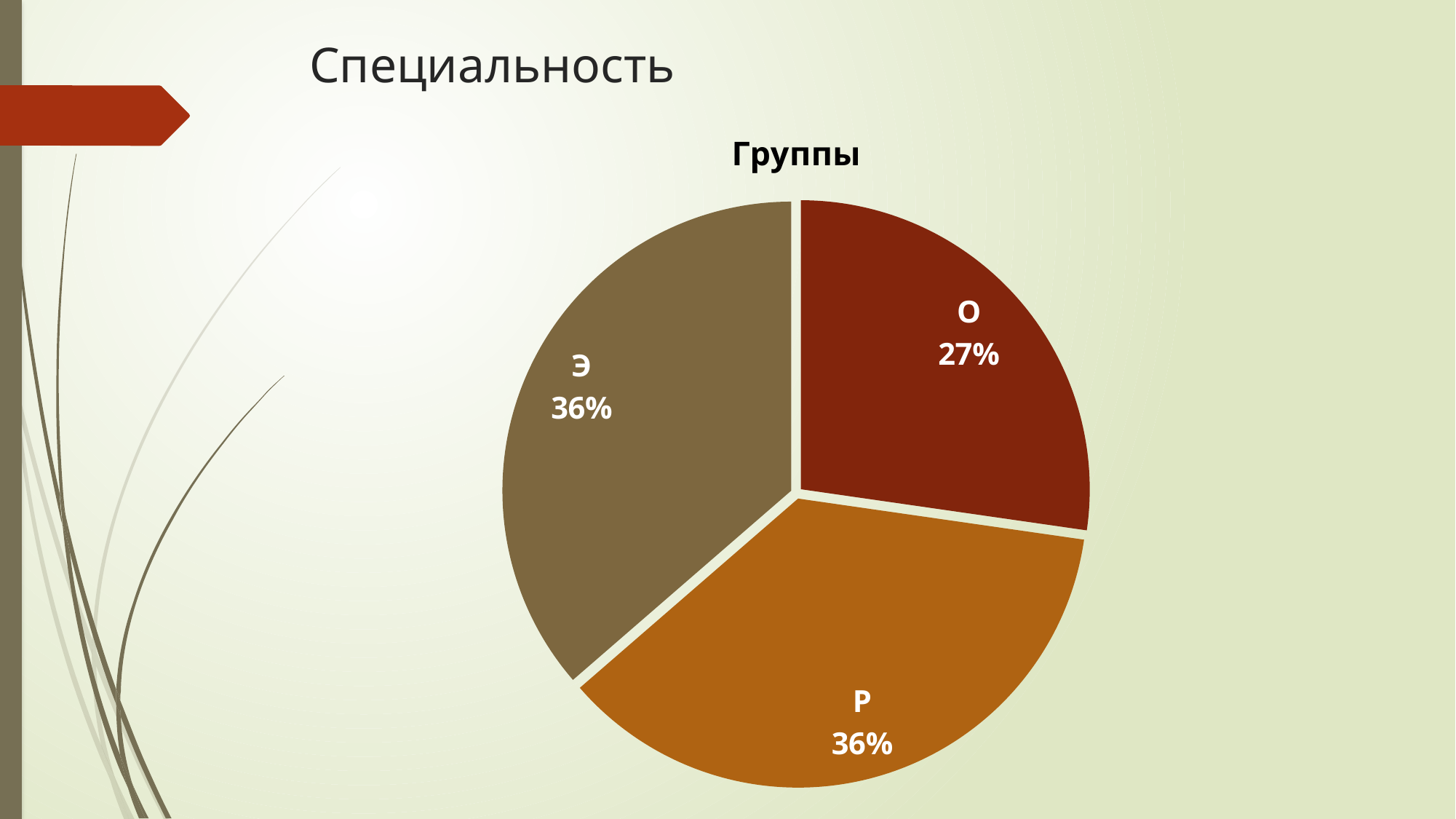
What percentage does the Э slice represent in the Группы pie chart? 36% Do the Р and Э slices in the Группы pie chart have the same percentage? Yes What type of chart is shown on the slide? Pie chart By how many percentage points does the Р share exceed the О share in the Группы pie chart? 9 Which group has the smallest share in the Группы pie chart? О What is the title of the slide? Специальность How many slices does the Группы pie chart have? 3 Which is larger in the Группы pie chart, the share for О or the share for Р? Р Which is larger in the Группы pie chart, the share for Э or the share for О? Э What percentage does the Р slice represent in the Группы pie chart? 36% What percentage does the О slice represent in the Группы pie chart? 27% What is the title of the chart on the slide? Группы